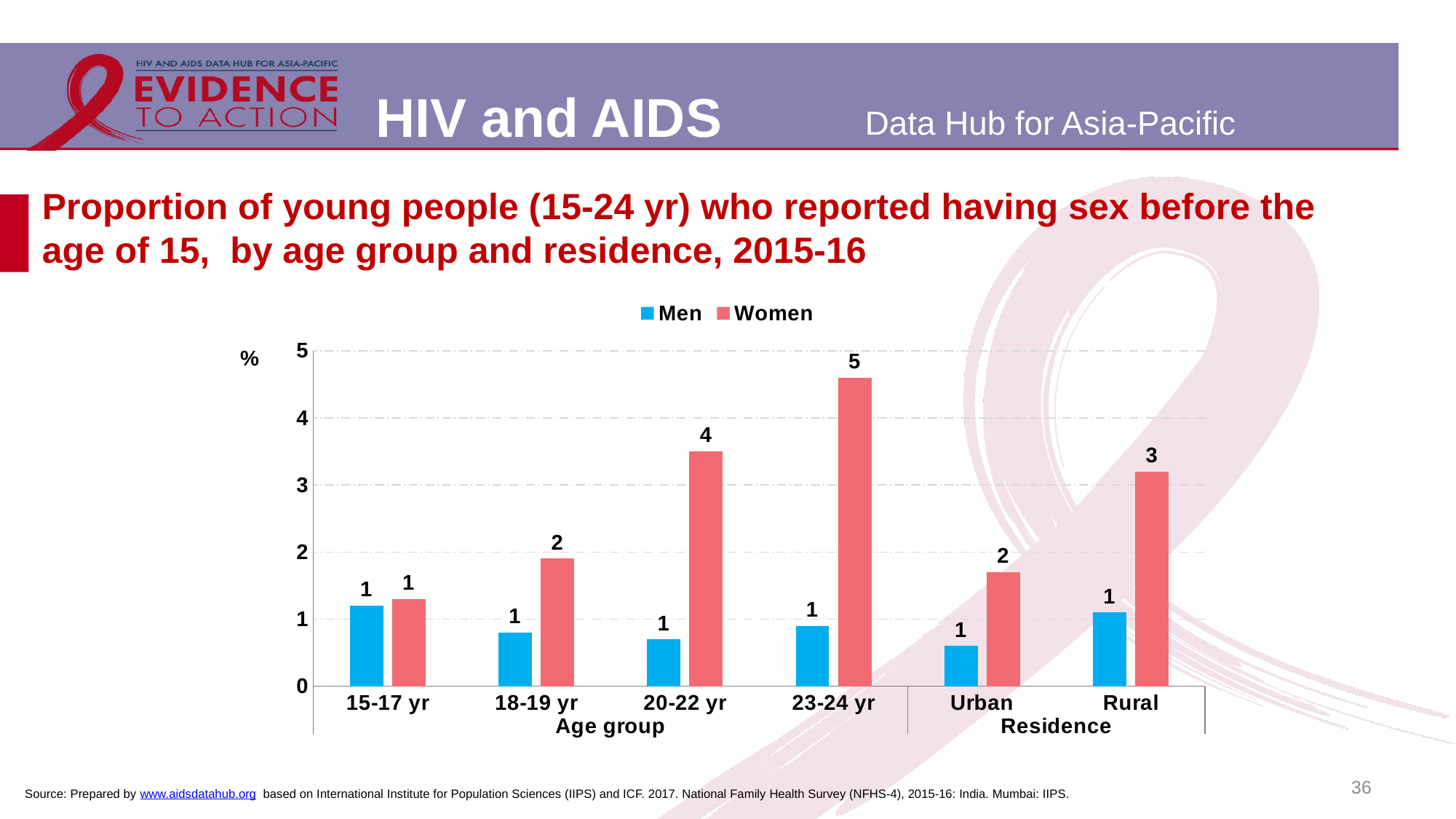
What value is labelled for Men in the Rural category? 1 What value is labelled for Women in the Rural category? 3 How many series does the legend list? 2 How many categories are shown on the x axis? 6 What value is labelled for Women in the 23-24 yr age group? 5 Which age group has the lowest value for Women? 15-17 yr In the 23-24 yr age group, which is larger, the value for Men or for Women? Women Do the values for Women rise or fall across the age groups from 15-17 yr to 23-24 yr? rise What value is labelled for Women in the 20-22 yr age group? 4 Which category has the highest value for Women? 23-24 yr